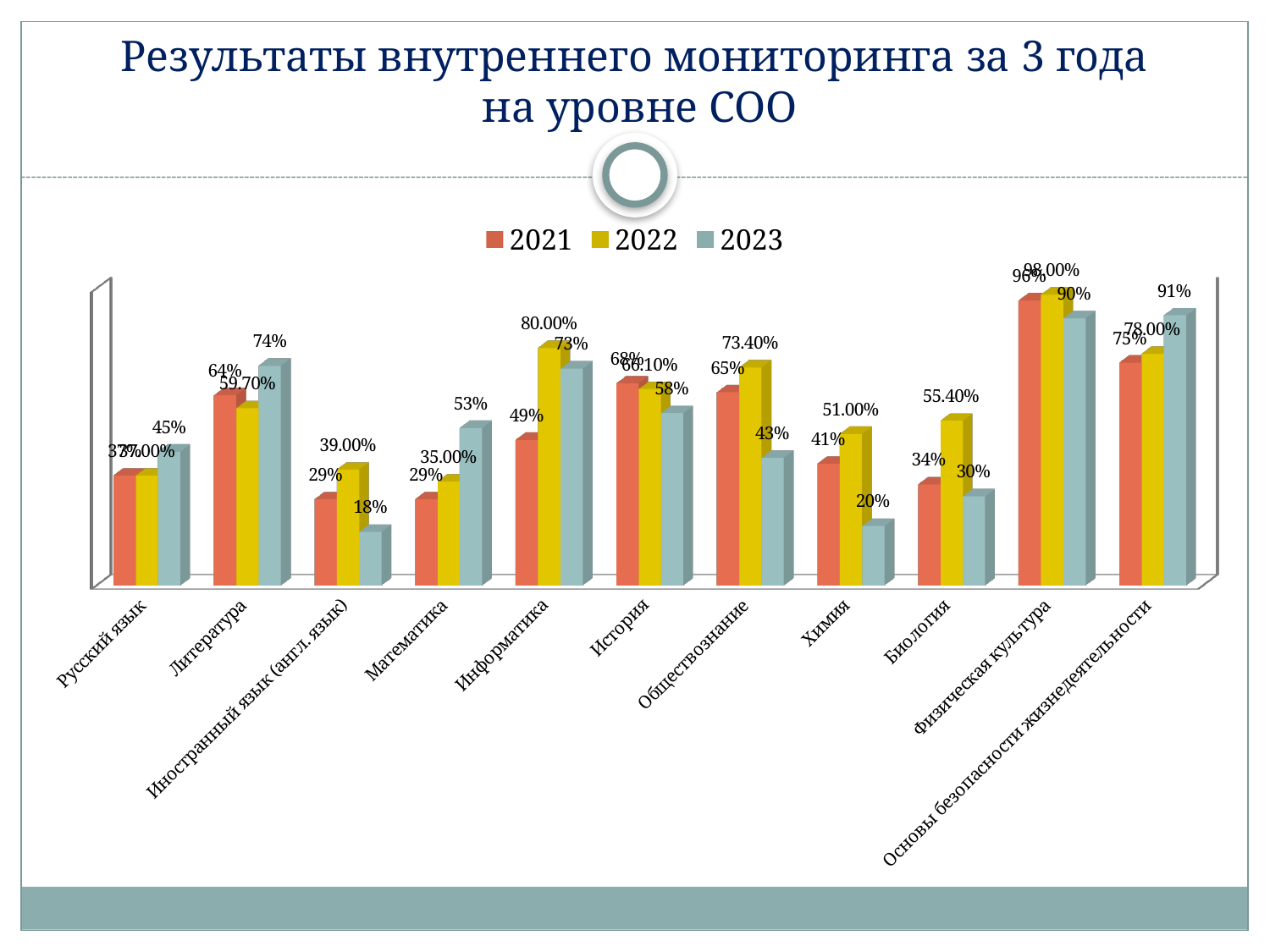
How many subject categories are shown on the x axis? 11 How many series does the legend list? 3 What kind of chart is shown on the slide? Bar chart What is the value for Обществознание in 2022? 73.40% What is the value for Химия in 2023? 20% Which subject has the lowest value for 2023? Иностранный язык (англ. язык) What is the value for Информатика in 2022? 80.00% For Биология, which year has the larger value, 2021 or 2022? 2022 What is the value for Литература in 2023? 74% By how many percentage points did Математика increase from 2021 to 2023? 24 Do the values for Математика rise or fall from 2021 to 2023? Rise Which subject has the highest value for 2023? Основы безопасности жизнедеятельности